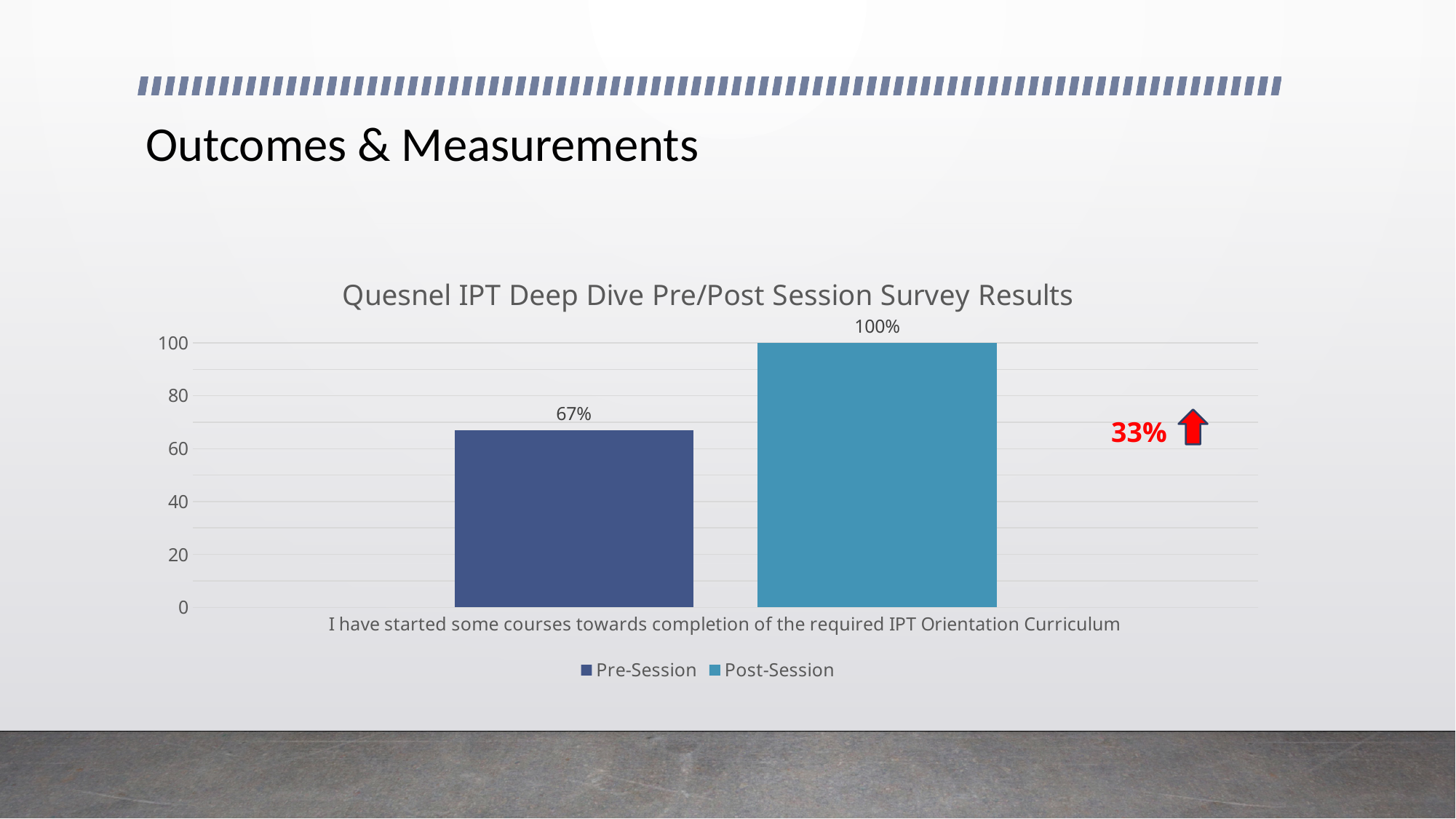
What is the difference between the Post-Session and Pre-Session values? 33% What is the title of the chart? Quesnel IPT Deep Dive Pre/Post Session Survey Results What kind of chart is shown on the slide? Bar chart Which series has the higher value, Pre-Session or Post-Session? Post-Session What is the Pre-Session value for "I have started some courses towards completion of the required IPT Orientation Curriculum"? 67% How many series does the legend list? 2 Is the Pre-Session value greater or less than 60? greater How many categories are shown on the x axis? 1 What is the Post-Session value for "I have started some courses towards completion of the required IPT Orientation Curriculum"? 100% What is the highest value shown on the vertical axis? 100 What are the two series listed in the legend? Pre-Session and Post-Session Is the Pre-Session value greater or less than 80? less